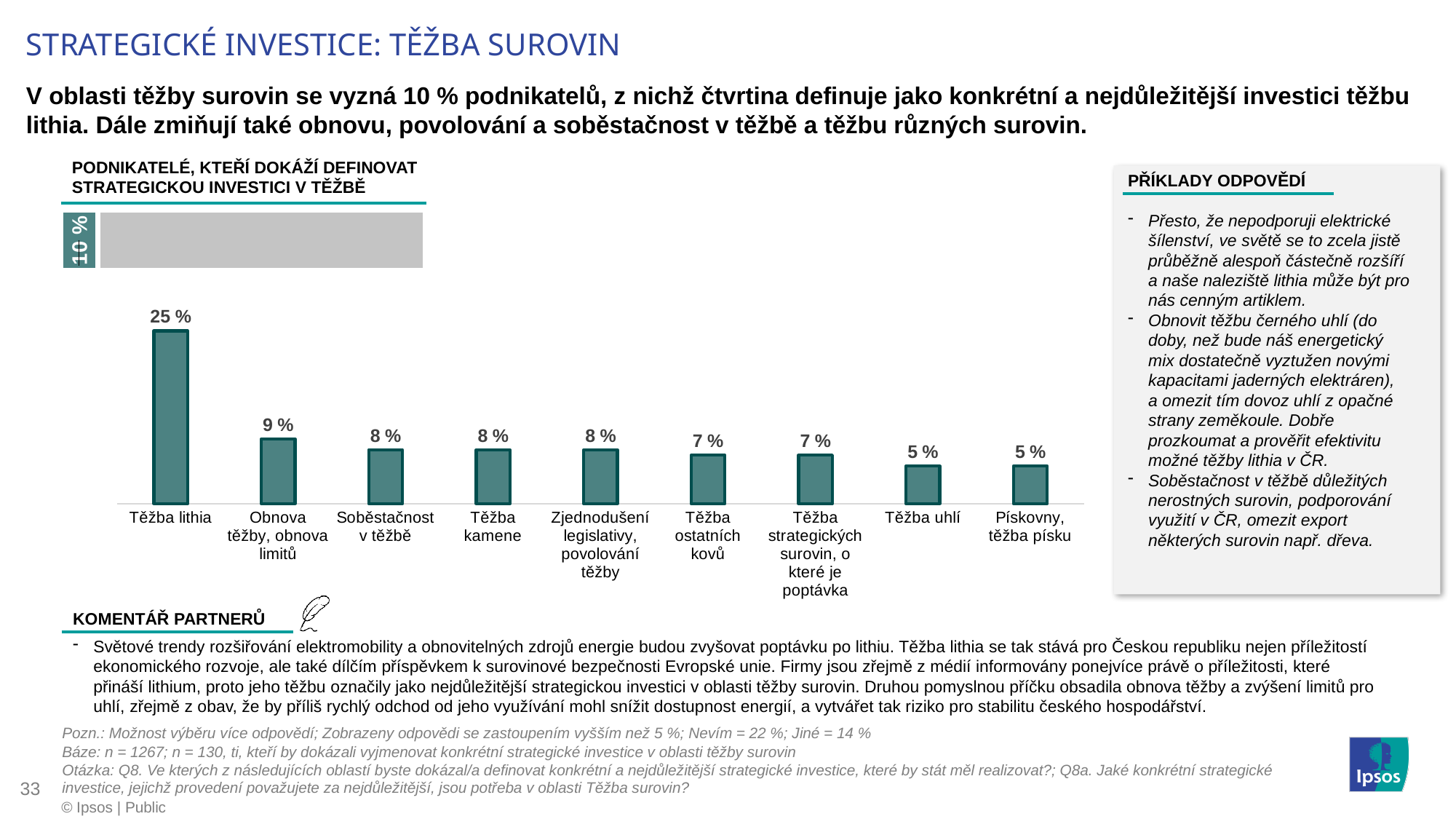
Which is larger, the value for Těžba kamene or the value for Pískovny, těžba písku? Těžba kamene What is the value for Těžba uhlí? 5 % What percentage is shown in the grey bar above the chart, labelled as the share of entrepreneurs who can define a strategic investment in mining? 10 % What is the value for Těžba ostatních kovů? 7 % Do the values rise or fall from left to right along the x axis? Fall What is the value for Těžba lithia? 25 % What kind of chart is shown on the slide? Bar chart What is the difference between the values for Těžba lithia and Obnova těžby, obnova limitů? 16 % What is the value for Zjednodušení legislativy, povolování těžby? 8 % What is the value for Obnova těžby, obnova limitů? 9 % How many categories are shown in the bar chart? 9 Which category has the highest value? Těžba lithia